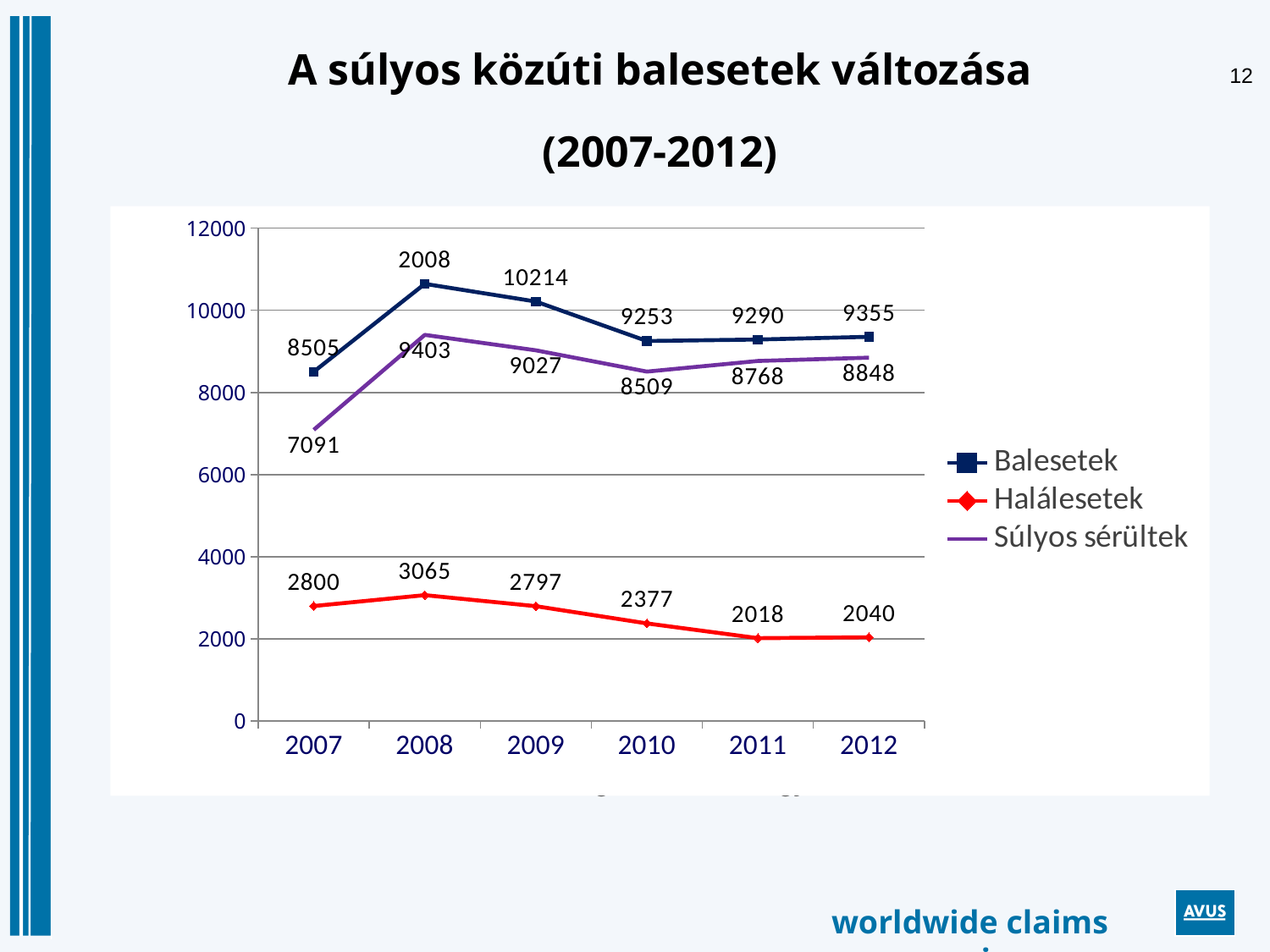
Is the value for Balesetek in 2008 greater or less than 10000? greater What is the value of Halálesetek in 2008? 3065 Which is larger: Súlyos sérültek in 2011 or Súlyos sérültek in 2010? Súlyos sérültek in 2011 What is the difference between Halálesetek in 2007 and in 2012? 760 In which year is Súlyos sérültek highest? 2008 How many series does the legend list? 3 How many years are plotted along the x axis? 6 In which year is Halálesetek lowest? 2011 What type of chart is shown on the slide? line chart Does Halálesetek rise or fall from 2008 to 2011? fall What is the value of Balesetek in 2012? 9355 What is the value of Súlyos sérültek in 2007? 7091